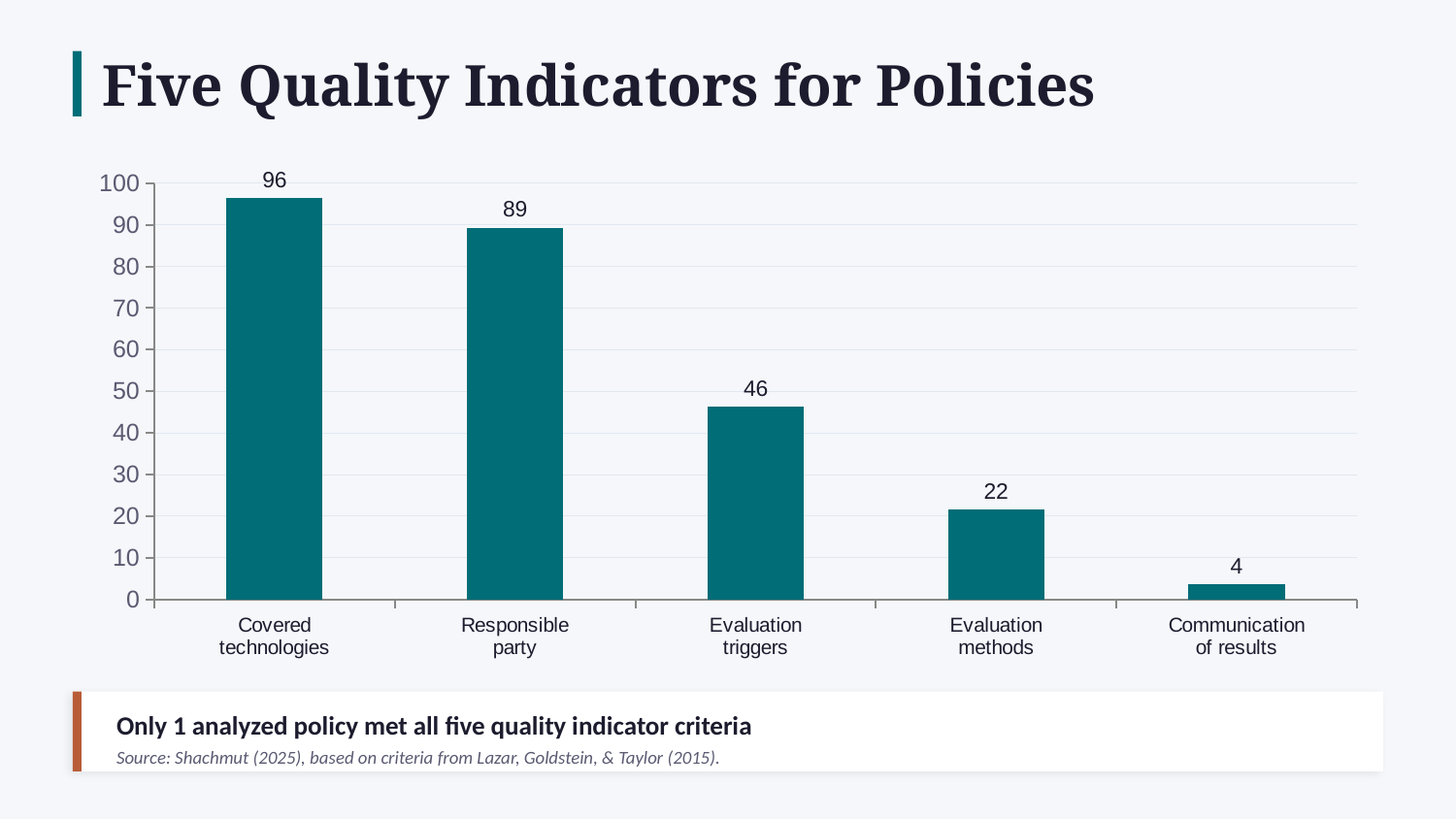
Do the values rise or fall from left to right across the categories? fall Which category has the highest value? Covered technologies What is the value for Communication of results? 4 Which is larger, the value for Responsible party or the value for Evaluation triggers? Responsible party What is the value for Evaluation triggers? 46 What is the difference between the values for Covered technologies and Responsible party? 7 Which category has the lowest value? Communication of results Is the value for Evaluation methods greater or less than 30? less What is the difference between the values for Evaluation triggers and Evaluation methods? 24 What is the value for Covered technologies? 96 How many categories are shown on the chart? 5 What kind of chart is shown on the slide? bar chart